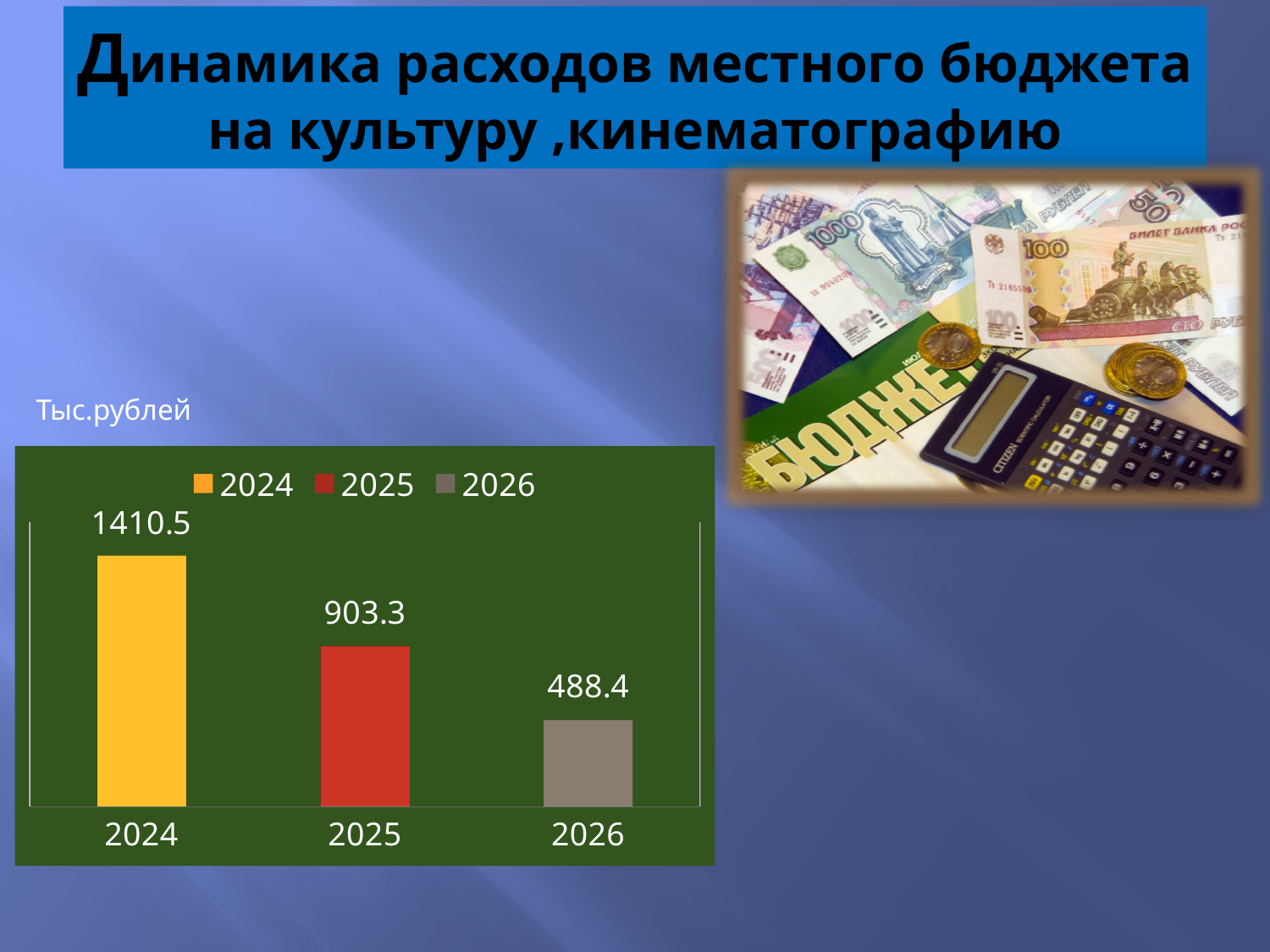
How many bars are shown in the chart? 3 What kind of chart is shown on the slide? bar chart What is the difference between the values for 2024 and 2025? 507.2 Which year has the highest value? 2024 What is the value for 2026? 488.4 Which year has the lowest value? 2026 Which is larger, the value for 2025 or the value for 2026? 2025 What is the value for 2025? 903.3 How many entries does the legend list? 3 What is the value for 2024? 1410.5 Do the values rise or fall from 2024 to 2026? fall What is the difference between the values for 2025 and 2026? 414.9